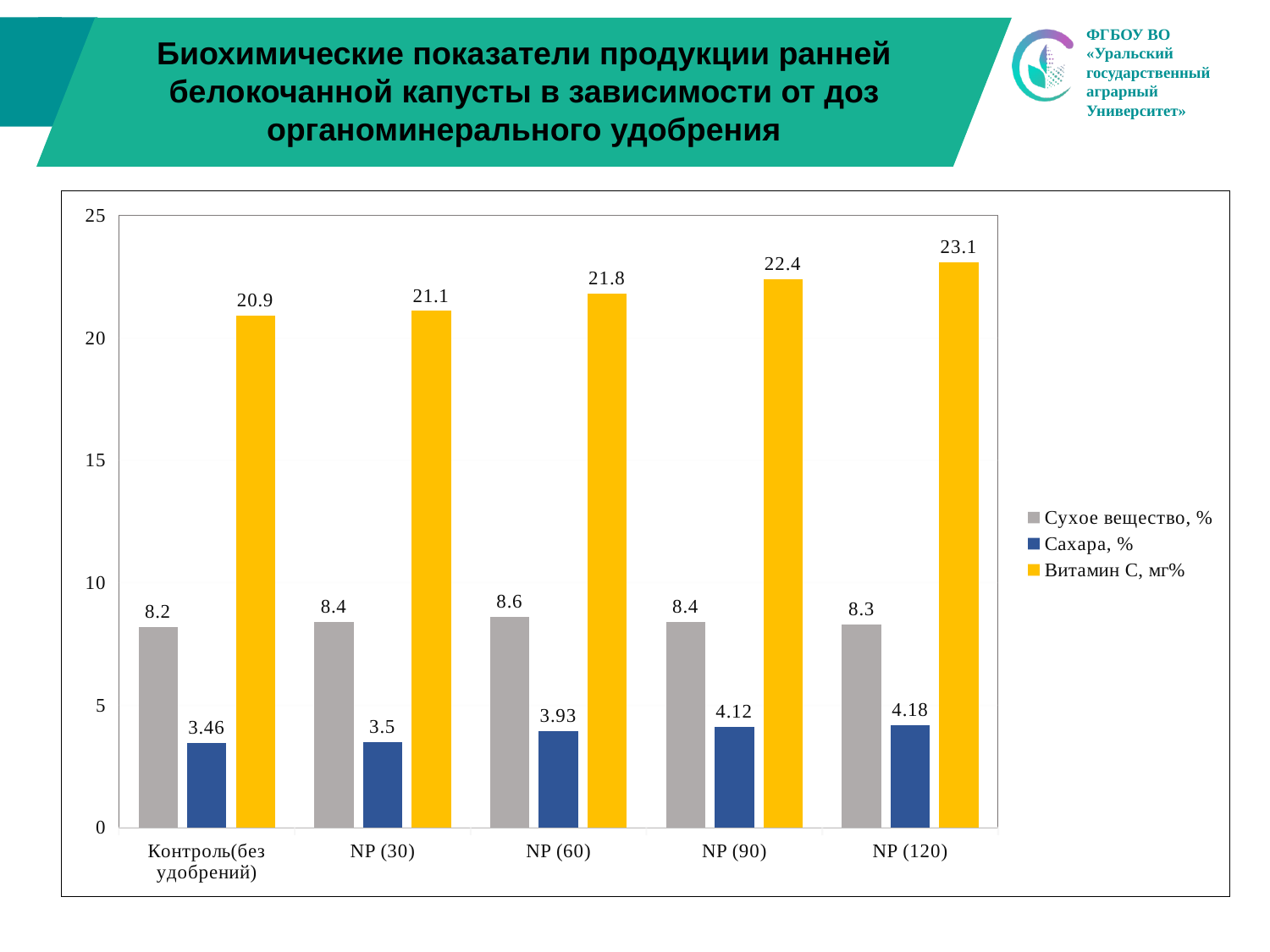
What is the value of Сахара, % for Контроль(без удобрений)? 3.46 Do the Витамин С, мг% values rise or fall from Контроль(без удобрений) to NP (120)? Rise What is the value of Витамин С, мг% for NP (90)? 22.4 Which category has the lowest value for Сахара, %? Контроль(без удобрений) What kind of chart is shown on the slide? Bar chart How many categories are shown on the x axis? 5 Which category has the highest value for Витамин С, мг%? NP (120) What is the value of Сухое вещество, % for NP (60)? 8.6 How many series does the legend list? 3 Is the value of Витамин С, мг% for NP (30) greater or less than 20? greater What is the difference between the Витамин С, мг% values for NP (120) and Контроль(без удобрений)? 2.2 Which is larger: Сахара, % for NP (60) or for NP (30)? NP (60)